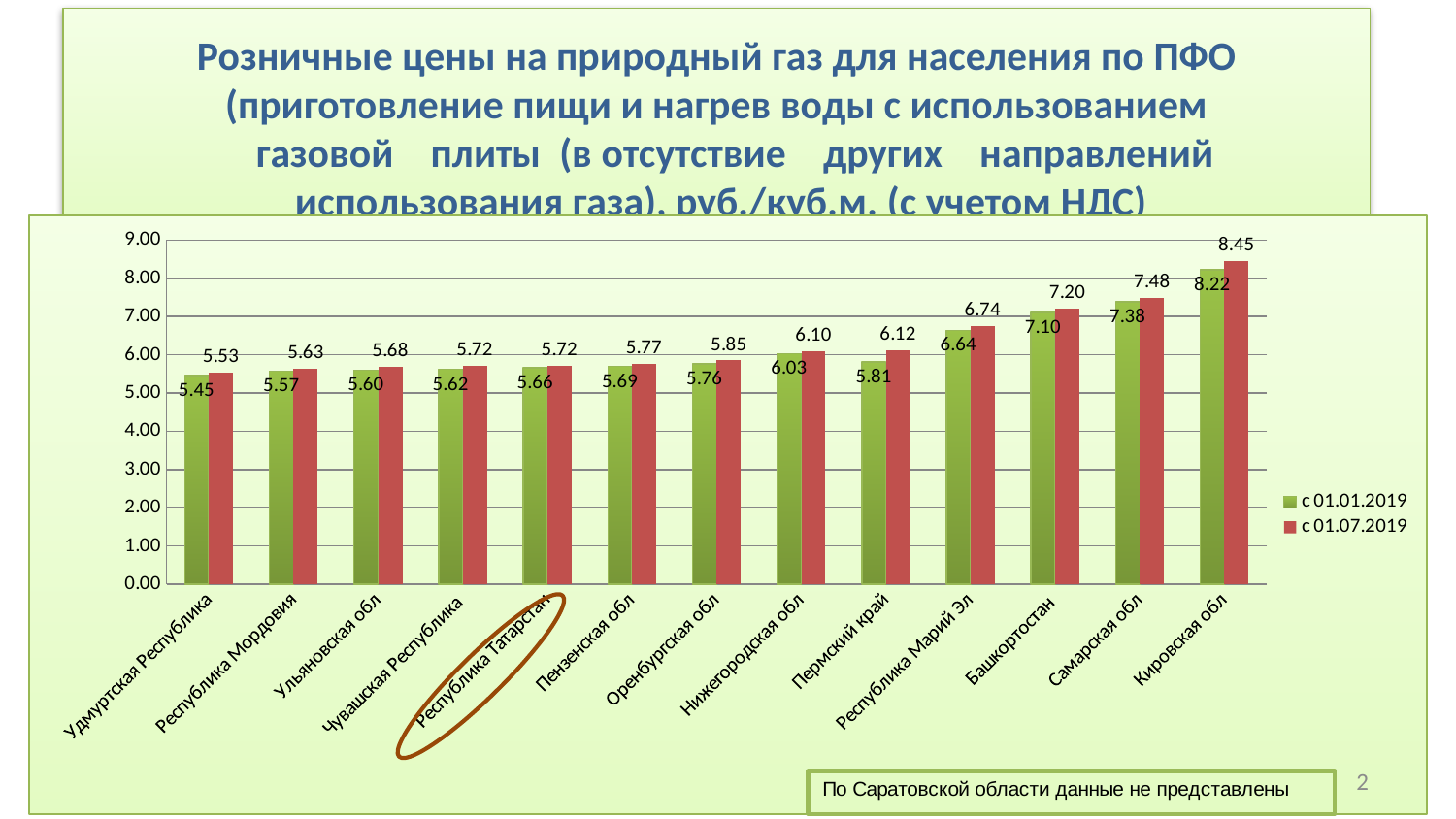
Which region on the x axis is circled on the slide? Республика Татарстан Which region has the lowest value in the series с 01.01.2019? Удмуртская Республика What is the value for Пермский край in the series с 01.01.2019? 5.81 Which is larger: the с 01.01.2019 value for Самарская обл or the с 01.01.2019 value for Башкортостан? Самарская обл What is the value for Башкортостан in the series с 01.07.2019? 7.20 How many regions are shown on the x axis of the chart? 13 Which region has the highest value in the series с 01.07.2019? Кировская обл How many series does the legend list? 2 What is the difference between the с 01.07.2019 and с 01.01.2019 values for Кировская обл? 0.23 Is the с 01.07.2019 value for Республика Марий Эл greater or less than 7.00? less What type of chart is shown on the slide? Bar chart What is the value for Республика Татарстан in the series с 01.07.2019? 5.72